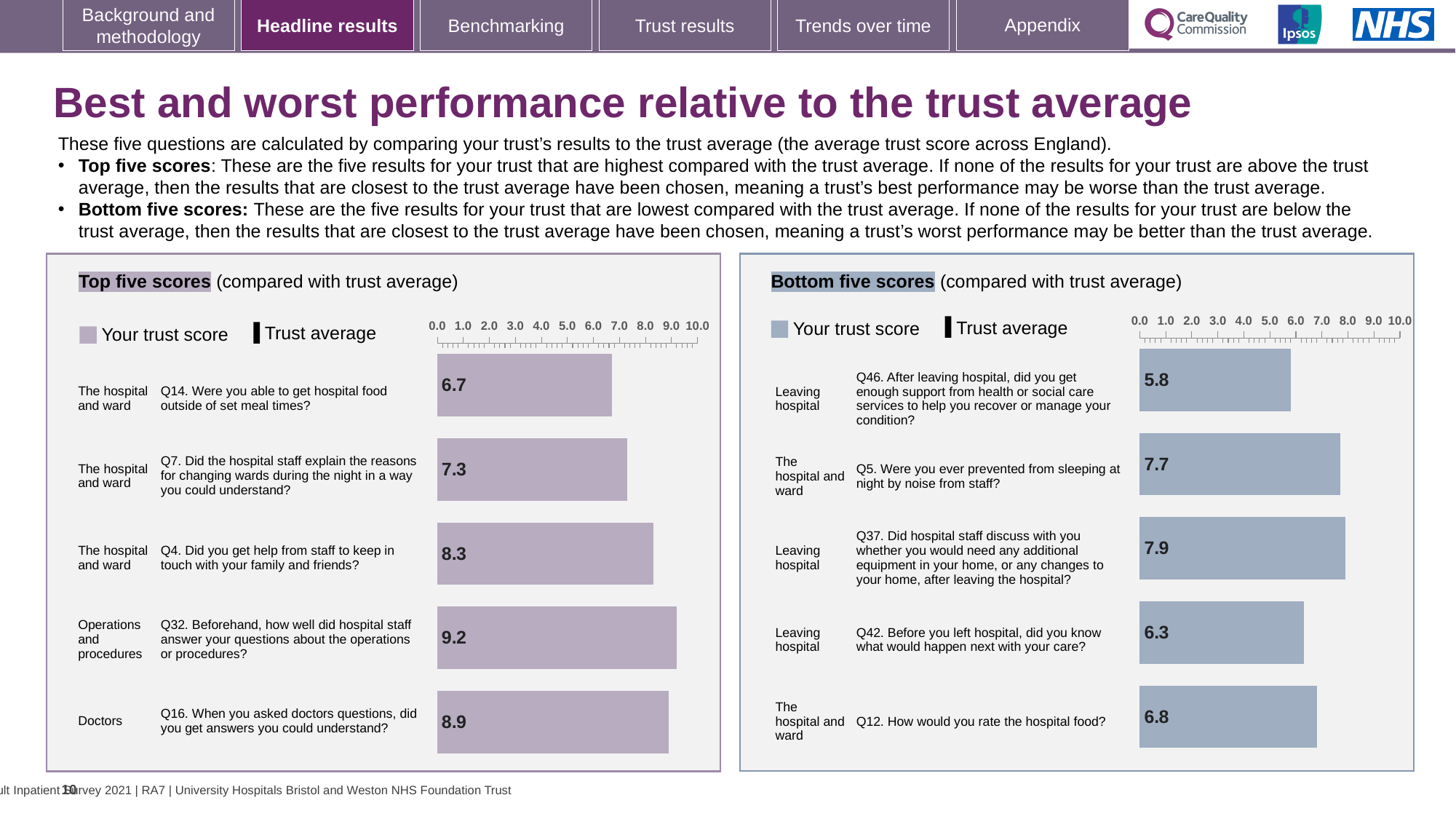
In the Bottom five scores chart, what is the difference between the scores for Q37 and Q46? 2.1 In the Bottom five scores chart, which has the higher score: Q5 or Q42? Q5 How many entries does the legend of the Bottom five scores chart list? 2 In the Top five scores chart, which question has the highest trust score? Q32. Beforehand, how well did hospital staff answer your questions about the operations or procedures? In the Bottom five scores chart, what is the trust score for Q12 (How would you rate the hospital food?)? 6.8 What type of chart is the Top five scores chart? bar chart In the Bottom five scores chart, which question has the lowest trust score? Q46. After leaving hospital, did you get enough support from health or social care services to help you recover or manage your condition? What is the maximum value shown on the axis of the Bottom five scores chart? 10.0 In the Top five scores chart, what is the trust score for Q14 (Were you able to get hospital food outside of set meal times?)? 6.7 In the Top five scores chart, is the value for Q16 greater or less than 8.0? greater In the Top five scores chart, what is the difference between the scores for Q32 and Q14? 2.5 How many questions are plotted in the Top five scores chart? 5